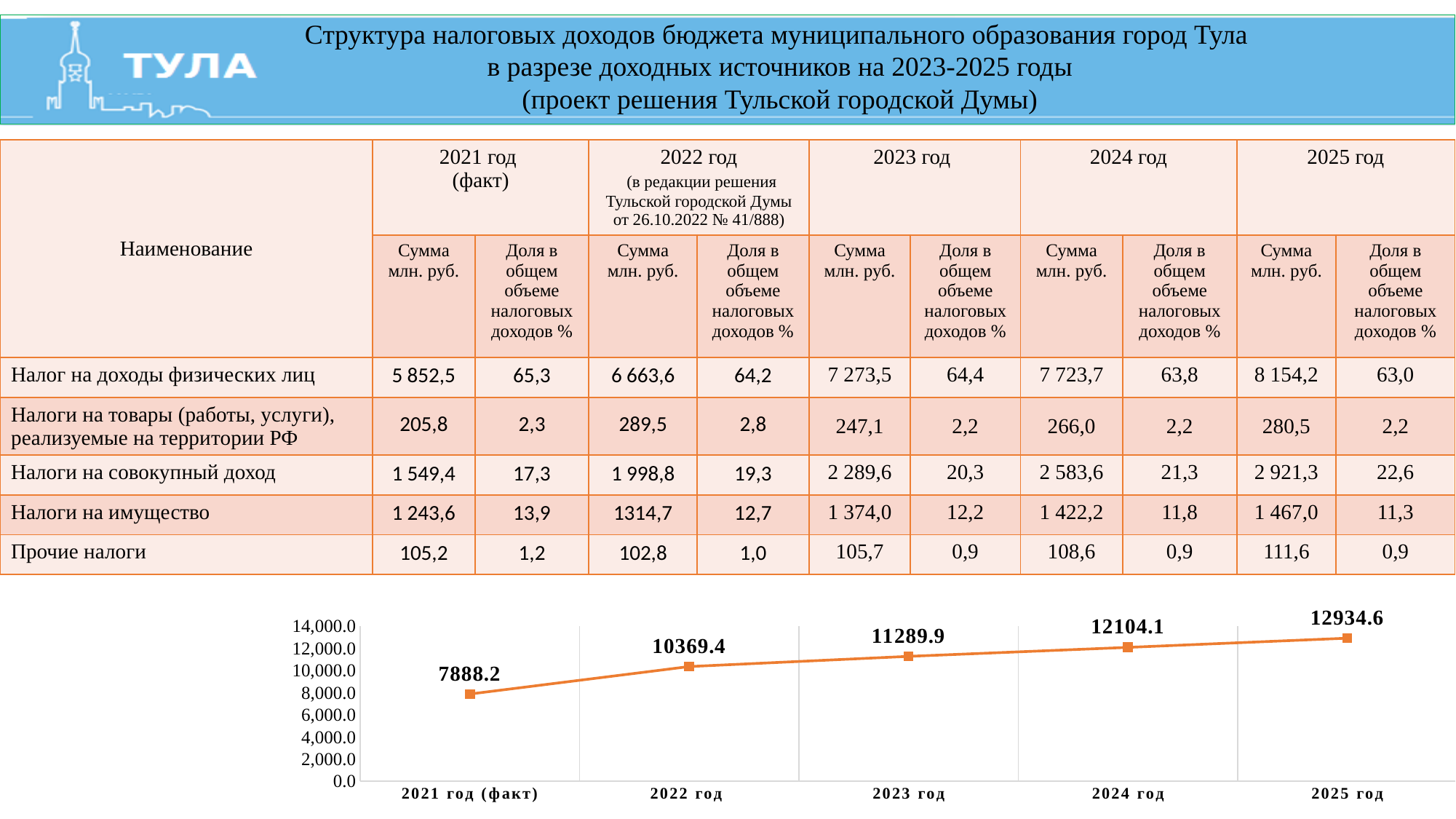
How many data points are plotted in the line chart? 5 Do the values in the line chart rise or fall from 2021 to 2025? rise In the line chart, what is the difference between the values for 2025 год and 2021 год (факт)? 5046.4 What is the value plotted for 2023 год in the line chart? 11289.9 What is the value plotted for 2021 год (факт) in the line chart? 7888.2 What is the value plotted for 2024 год in the line chart? 12104.1 Which year has the highest value in the line chart? 2025 год What is the value plotted for 2025 год in the line chart? 12934.6 What kind of chart is shown at the bottom of the slide? line chart What is the value plotted for 2022 год in the line chart? 10369.4 Which year has the lowest value in the line chart? 2021 год (факт) In the line chart, which is larger: the value for 2022 год or the value for 2023 год? 2023 год